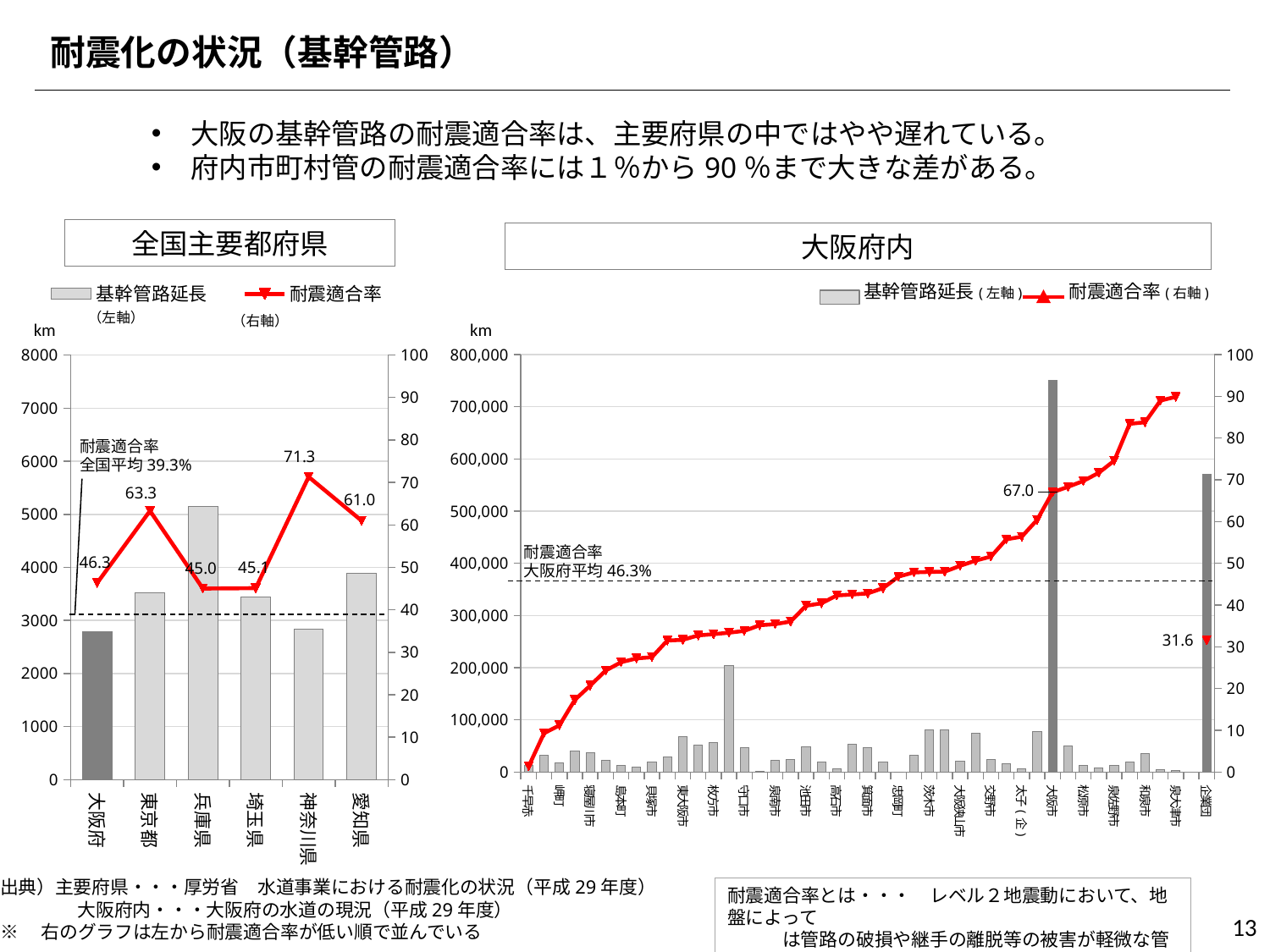
How many series does the legend of the 全国主要都府県 chart list? 2 How many prefectures are shown in the 全国主要都府県 chart? 6 In the 全国主要都府県 chart, what is the 耐震適合率 for 神奈川県? 71.3 In the 全国主要都府県 chart, what is the difference in 耐震適合率 between 神奈川県 and 大阪府? 25.0 In the 大阪府内 chart, which municipality has the longest 基幹管路延長 bar? 大阪市 In the 全国主要都府県 chart, which has the higher 耐震適合率, 東京都 or 愛知県? 東京都 In the 全国主要都府県 chart, what is the 耐震適合率 for 大阪府? 46.3 In the 大阪府内 chart, what is the 耐震適合率 for 大阪市? 67.0 In the 全国主要都府県 chart, which prefecture has the longest 基幹管路延長 bar? 兵庫県 In the 全国主要都府県 chart, which prefecture has the highest 耐震適合率? 神奈川県 In the 全国主要都府県 chart, is the 基幹管路延長 for 兵庫県 greater or less than 5000 km? greater In the 全国主要都府県 chart, what national average 耐震適合率 is annotated? 39.3%